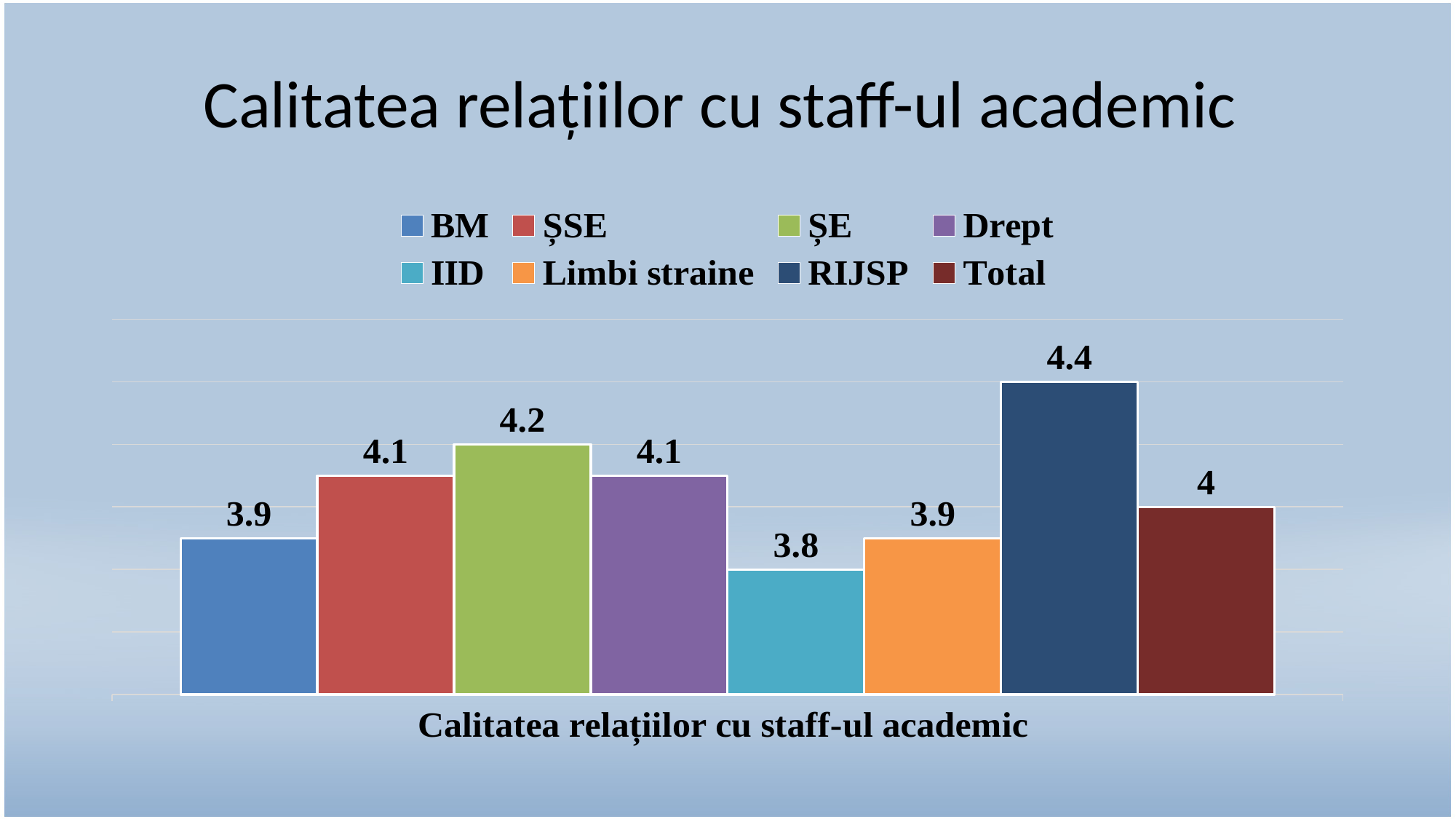
How many series does the legend list? 8 What is the title of the chart? Calitatea relațiilor cu staff-ul academic What is the value for RIJSP? 4.4 What is the difference between the values for RIJSP and IID? 0.6 What is the value for ȘE? 4.2 Which series has the highest value? RIJSP Which series has the lowest value? IID What kind of chart is shown on the slide? bar chart Which is larger, the value for ȘSE or the value for Limbi straine? ȘSE What is the value for IID? 3.8 What is the value for Total? 4 What is the difference between the values for ȘE and BM? 0.3